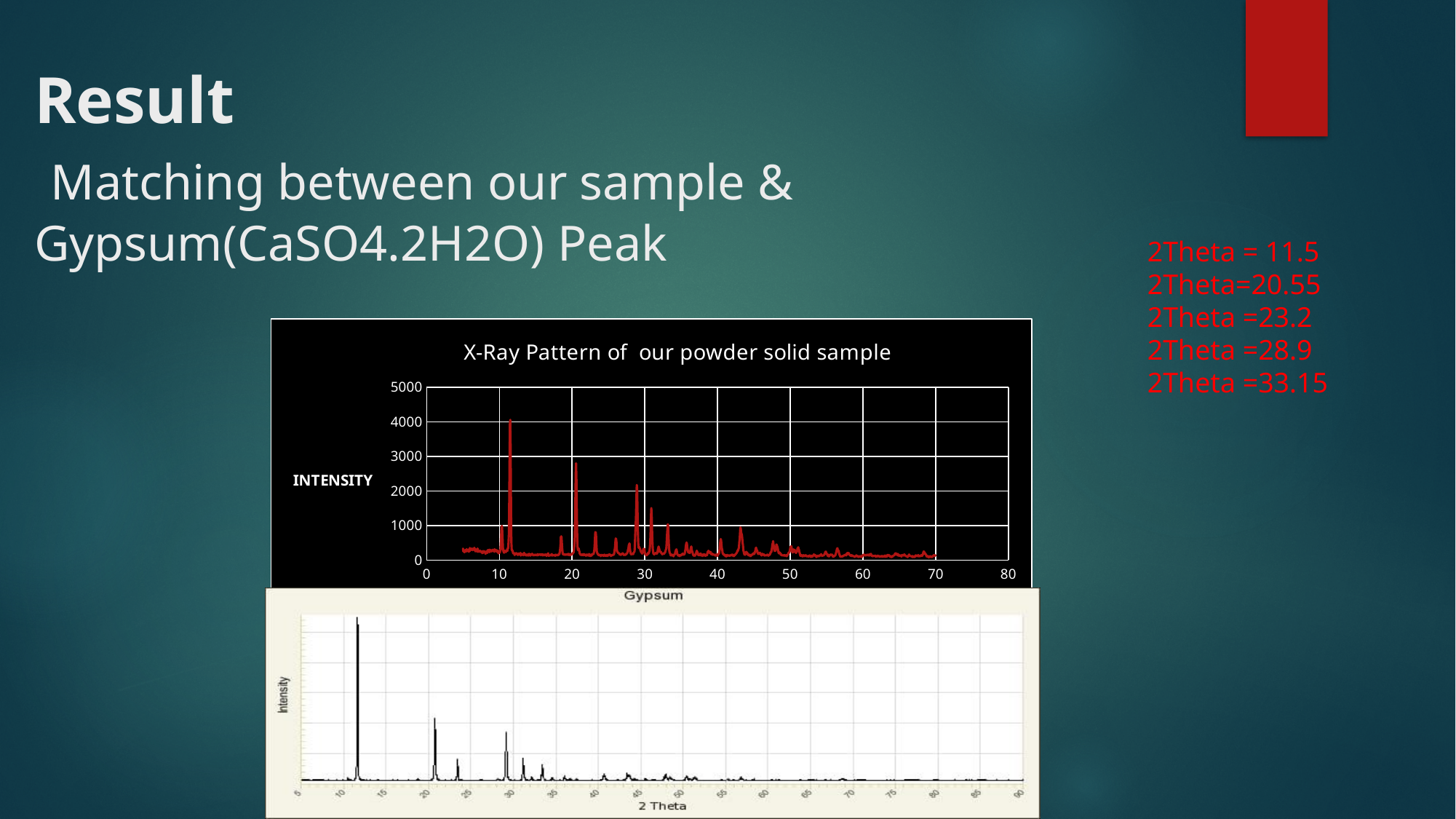
In the top chart, is the intensity of the peak near 2Theta = 20.55 greater or less than 3000? less In the top chart, is the intensity of the tallest peak (near 2Theta = 11.5) greater or less than 3000? greater In the bottom chart titled "Gypsum", is the tallest peak located at a 2 Theta value less than or greater than 20? less What is the title of the top chart on the slide? X-Ray Pattern of our powder solid sample In the top chart, does the overall peak intensity rise or fall as 2Theta increases from 10 to 70? fall What is the title of the bottom chart on the slide? Gypsum What kind of chart is the top chart titled "X-Ray Pattern of our powder solid sample"? line chart How many tick labels are shown on the x axis of the top chart (from 0 to 80)? 9 In the top chart, which peak is taller: the one near 2Theta = 11.5 or the one near 2Theta = 20.55? the one near 2Theta = 11.5 In the top chart, what is the highest value shown on the intensity (y) axis? 5000